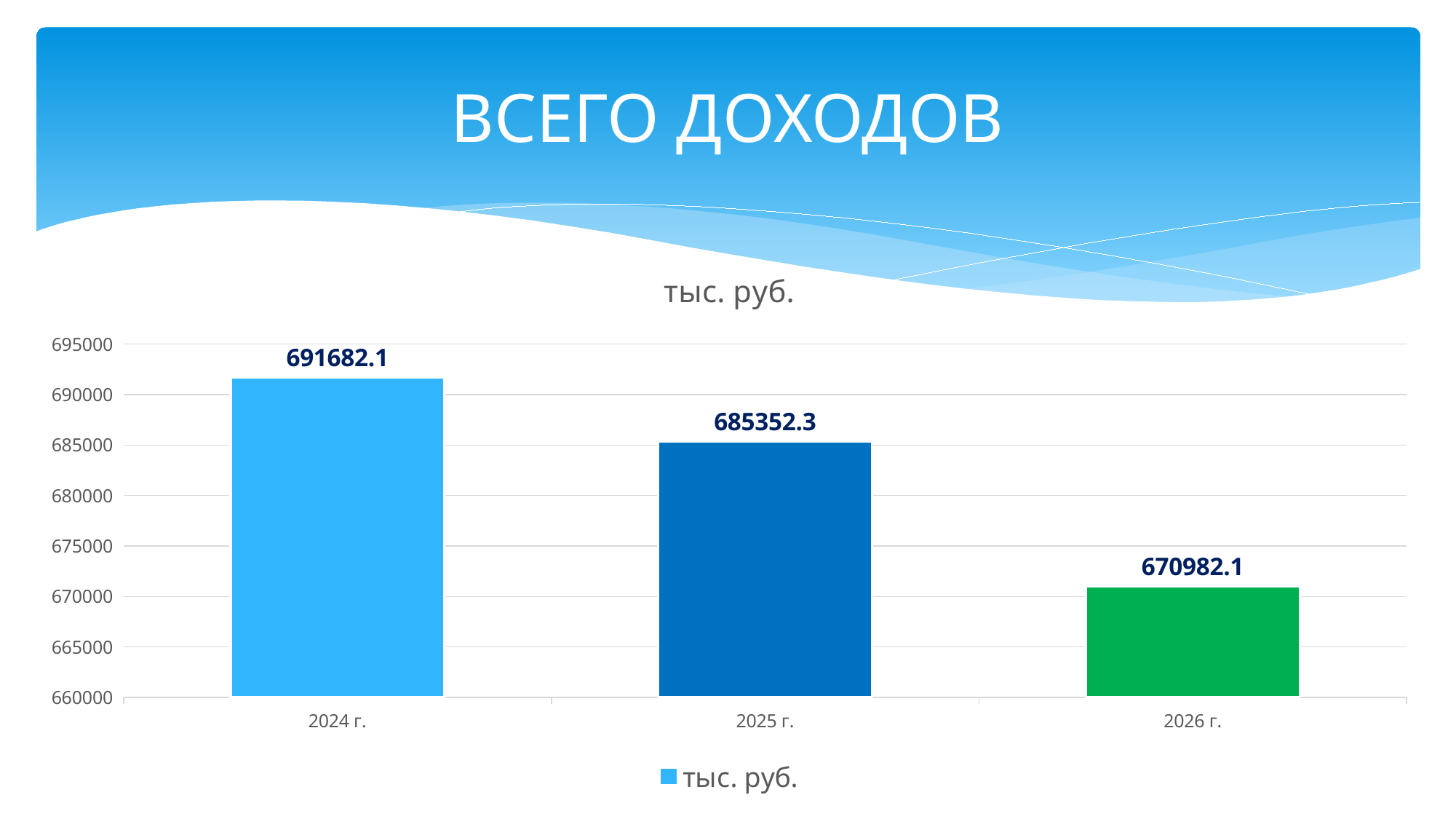
What kind of chart is shown on the slide? bar chart Which year has the lowest value? 2026 г. What is the difference between the values for 2024 г. and 2025 г.? 6329.8 Is the value for 2026 г. greater or less than 675000? less Which year has the highest value? 2024 г. What is the value for 2024 г.? 691682.1 Do the values rise or fall from 2024 г. to 2026 г.? fall How many years are shown on the chart? 3 Which is larger, the value for 2025 г. or the value for 2026 г.? 2025 г. What is the difference between the values for 2025 г. and 2026 г.? 14370.2 What is the value for 2025 г.? 685352.3 What is the value for 2026 г.? 670982.1